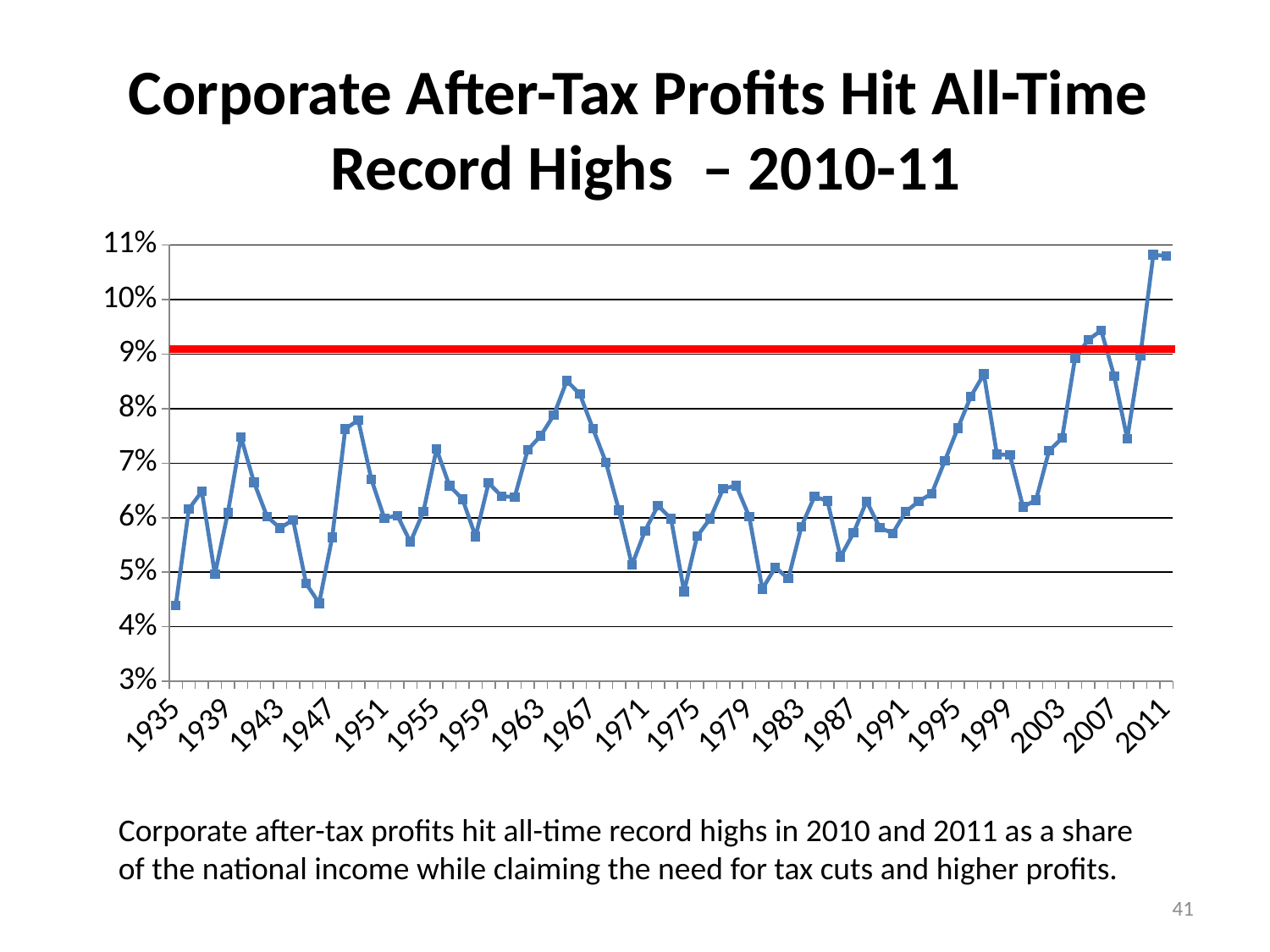
What kind of chart is shown on the slide? line chart Which year has the larger value, 1965 or 1935? 1965 Which year has the larger value, 2010 or 1997? 2010 What is the title of the chart on the slide? Corporate After-Tax Profits Hit All-Time Record Highs – 2010-11 Do the values generally rise or fall from 1965 to 1970? fall Is the value for 2010 greater or less than 10%? greater What is the first year labelled on the x axis? 1935 Is the value for 1974 greater or less than 5%? less Is the value for 1965 greater or less than 8%? greater Do the values generally rise or fall from 2001 to 2010? rise